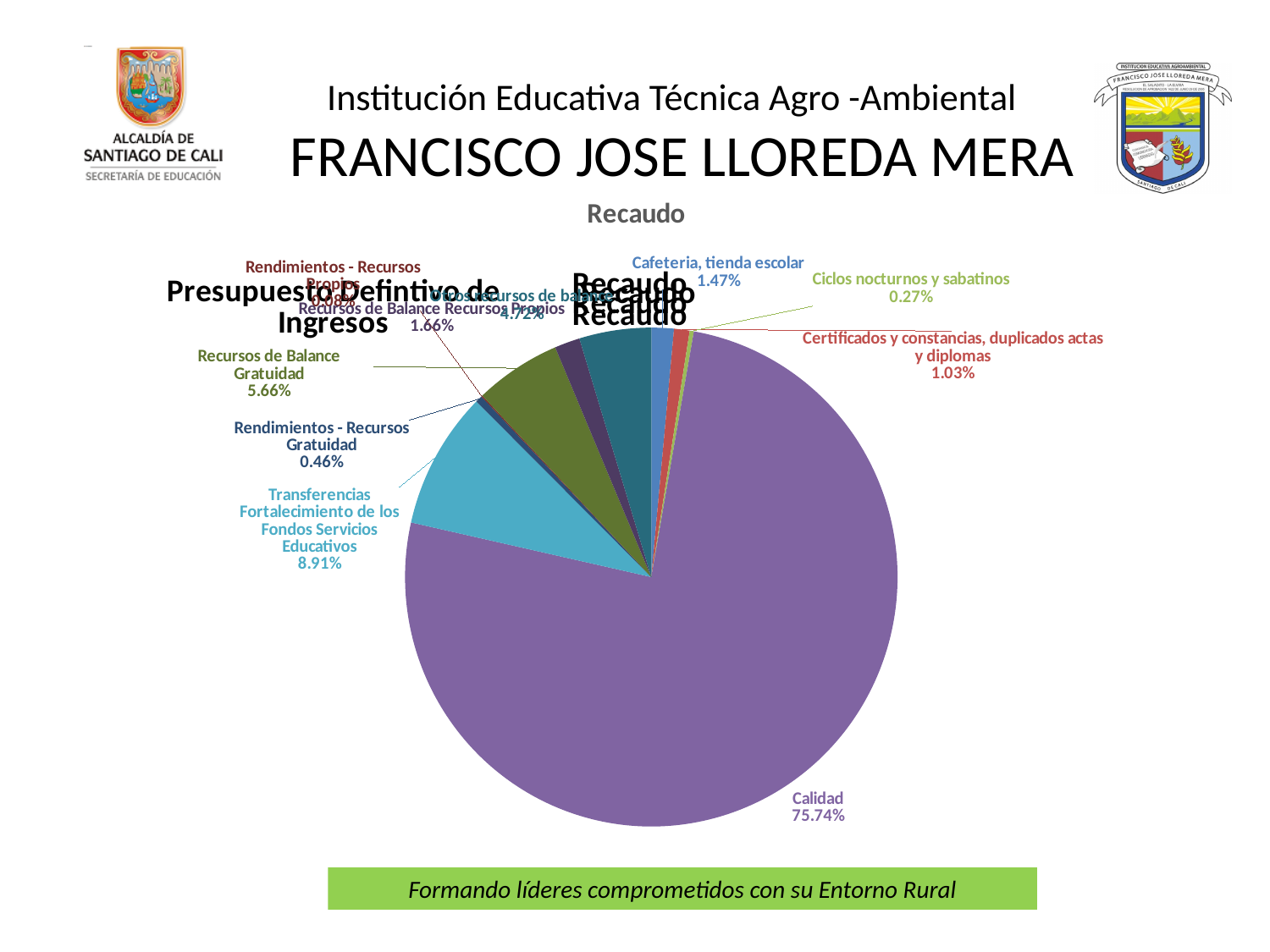
Which is larger, the share for Recursos de Balance Gratuidad or the share for Rendimientos - Recursos Gratuidad? Recursos de Balance Gratuidad What percentage is shown for Ciclos nocturnos y sabatinos? 0.27% What share of the pie does Calidad represent? 75.74% What percentage is shown for Cafeteria, tienda escolar? 1.47% What percentage is shown for Transferencias Fortalecimiento de los Fondos Servicios Educativos? 8.91% What percentage is shown for Certificados y constancias, duplicados actas y diplomas? 1.03% What is the difference in percentage points between Calidad and Transferencias Fortalecimiento de los Fondos Servicios Educativos? 66.83% What is the title of the chart? Recaudo Which is larger, the share for Cafeteria, tienda escolar or the share for Certificados y constancias, duplicados actas y diplomas? Cafeteria, tienda escolar Which category has the largest slice of the pie? Calidad What percentage is shown for Recursos de Balance Gratuidad? 5.66% What kind of chart is shown on the slide? pie chart